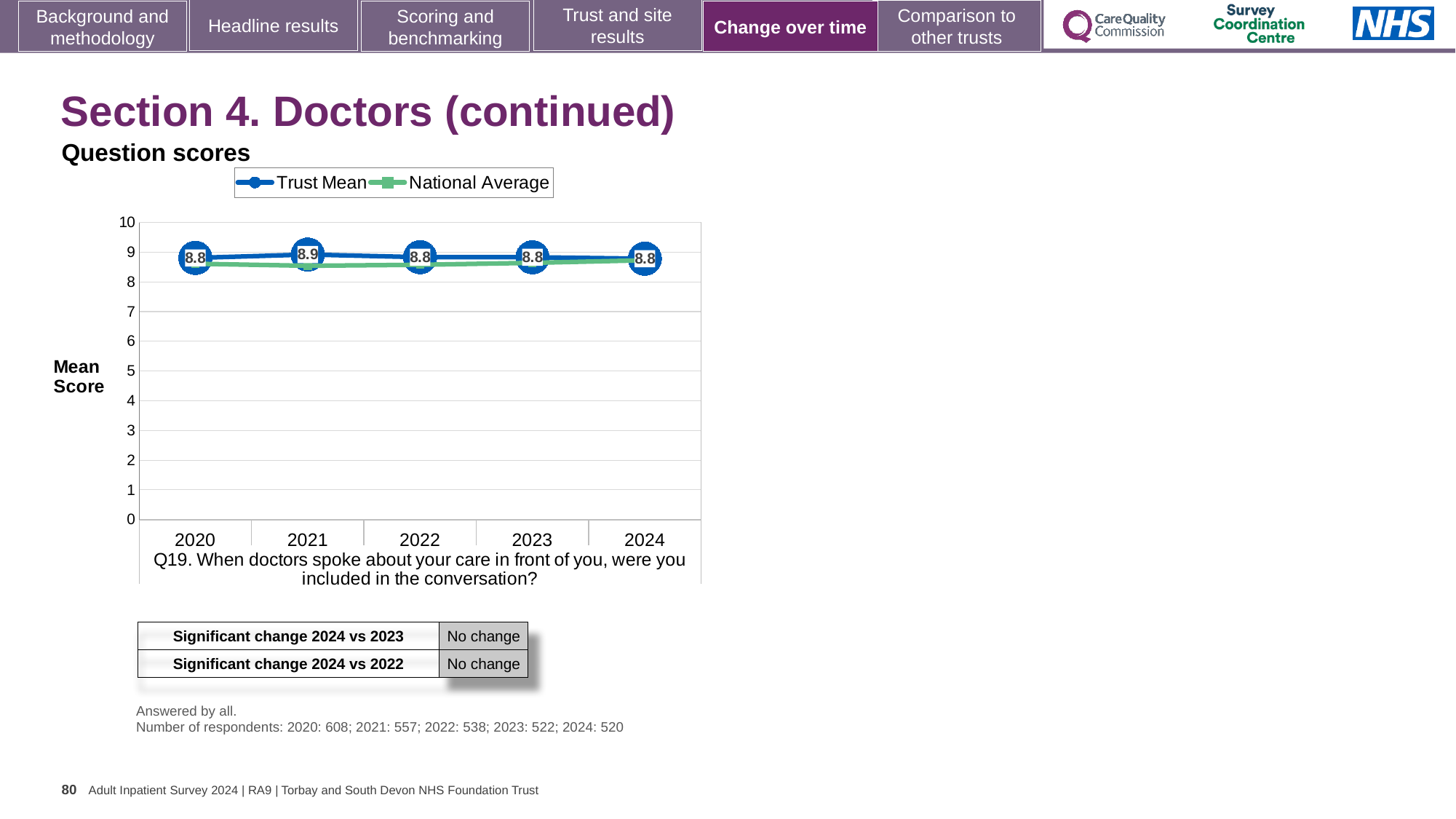
What type of chart is shown on the slide? line chart What are the two series named in the legend? Trust Mean and National Average In which year is the Trust Mean score highest? 2021 How many years are plotted along the x axis? 5 What is the Trust Mean score for 2021? 8.9 How many series does the legend list? 2 Is the National Average value for 2024 greater or less than 9? less What is the Trust Mean score for 2020? 8.8 What is the difference between the Trust Mean score in 2021 and in 2020? 0.1 Is the National Average value for 2020 greater or less than 8? greater What is the Trust Mean score for 2024? 8.8 Which survey question does the chart show scores for? Q19. When doctors spoke about your care in front of you, were you included in the conversation?